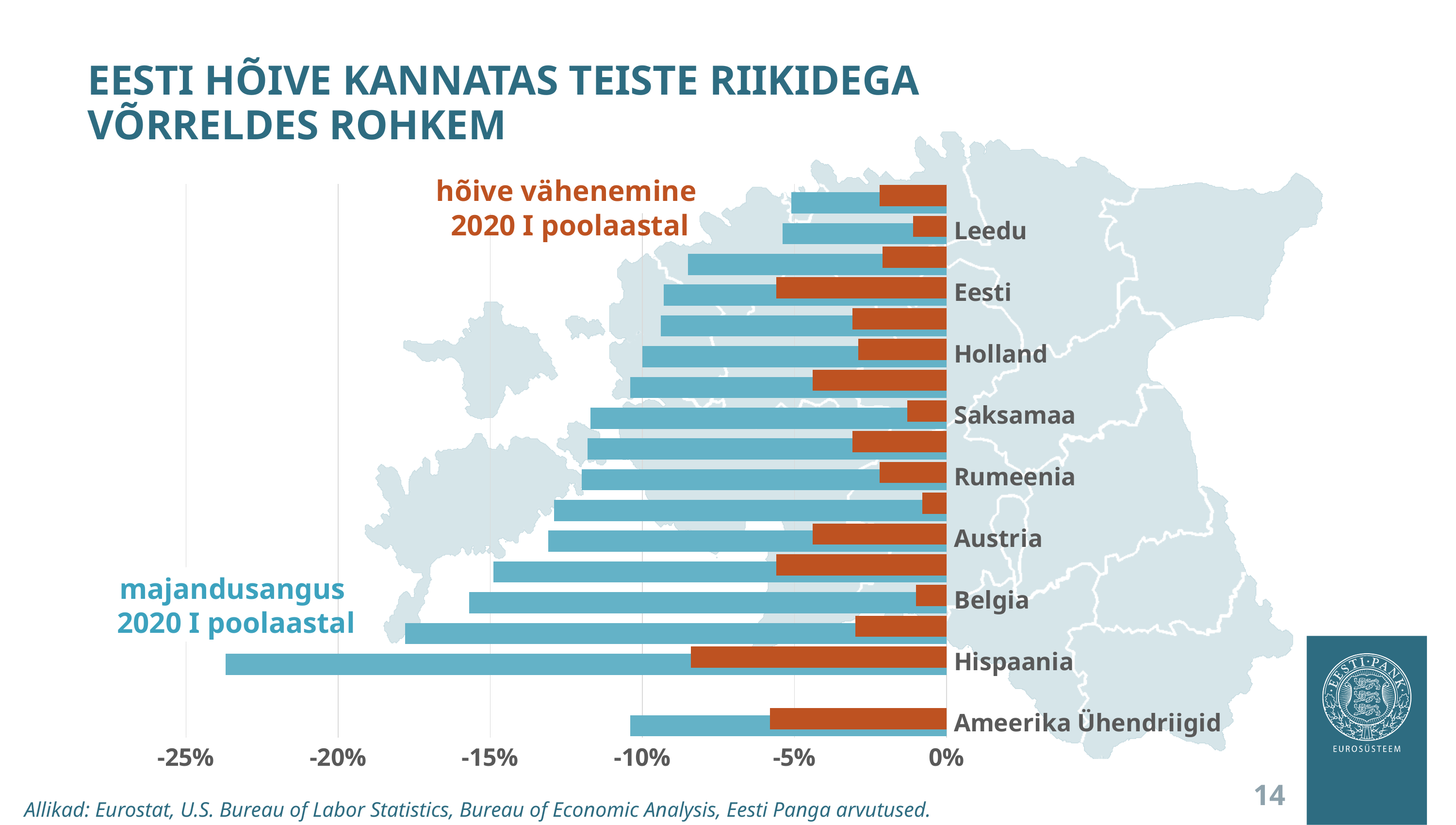
Is the economic decline (majandusangus) value for Hispaania greater or less than -20%? less Which labelled country has the smallest economic decline (majandusangus 2020 I poolaastal)? Leedu Which labelled country has the largest economic decline (majandusangus 2020 I poolaastal)? Hispaania Which labelled country has the largest employment decline (hõive vähenemine 2020 I poolaastal)? Hispaania Is the economic decline (majandusangus) value for Saksamaa greater or less than -10%? less Is the employment decline (hõive vähenemine) value for Austria greater or less than -5%? greater Which colour represents the series 'hõive vähenemine 2020 I poolaastal'? orange Which country shows a larger employment decline (hõive vähenemine), Eesti or Holland? Eesti How many data series does the chart show? 2 How many countries are labelled by name on the chart? 9 What kind of chart is shown on the slide? bar chart